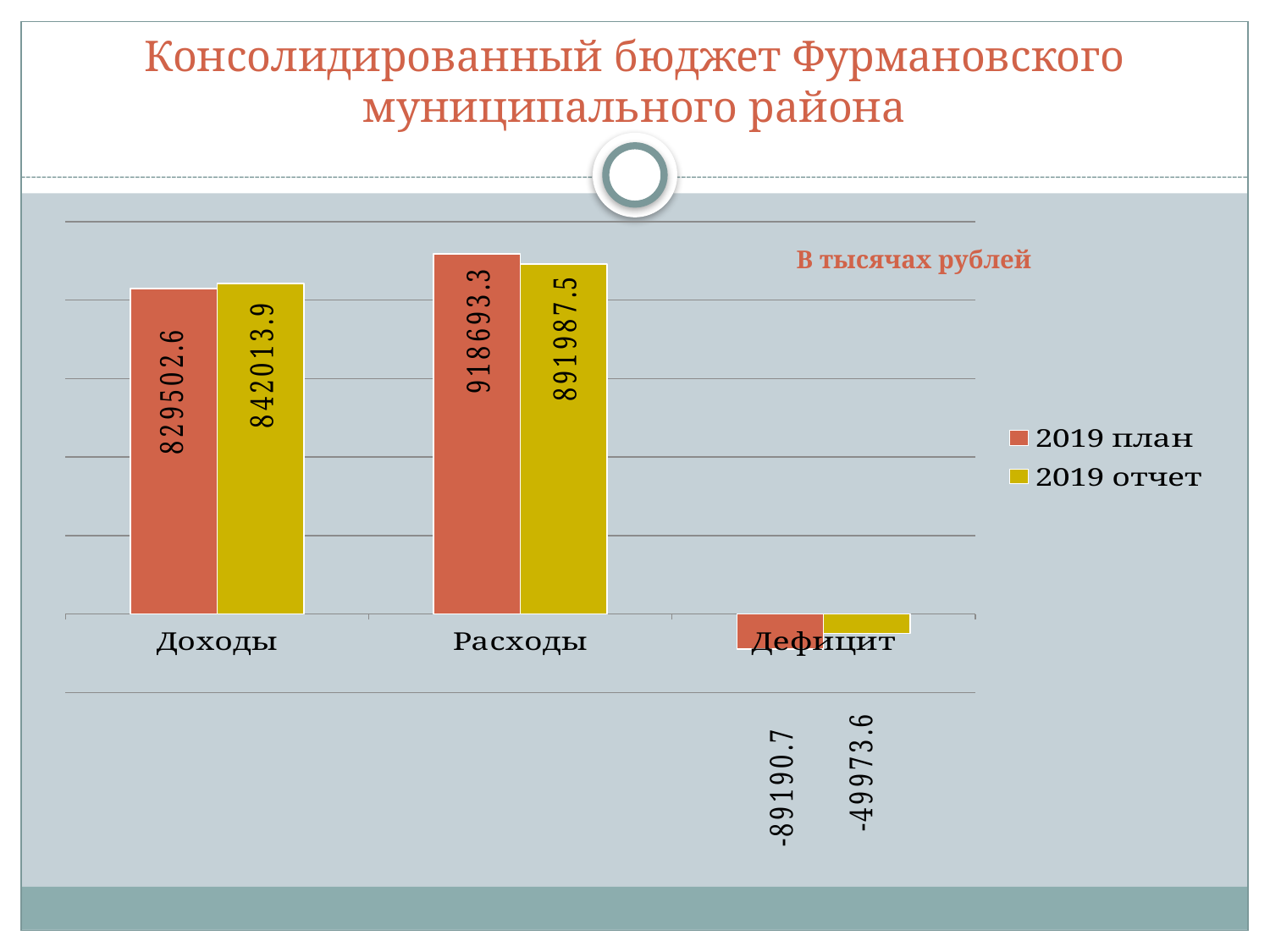
What is the 2019 план value for Доходы? 829502.6 What is the 2019 отчет value for Дефицит? -49973.6 Which category has the highest 2019 план value? Расходы Which category has the lowest 2019 отчет value? Дефицит What kind of chart is shown on the slide? Bar chart What is the 2019 отчет value for Расходы? 891987.5 What is the 2019 план value for Дефицит? -89190.7 How many series does the legend list? 2 For Доходы, which is larger: the 2019 план value or the 2019 отчет value? 2019 отчет What is the 2019 отчет value for Доходы? 842013.9 What is the difference between the 2019 план and 2019 отчет values for Расходы? 26705.8 What is the 2019 план value for Расходы? 918693.3